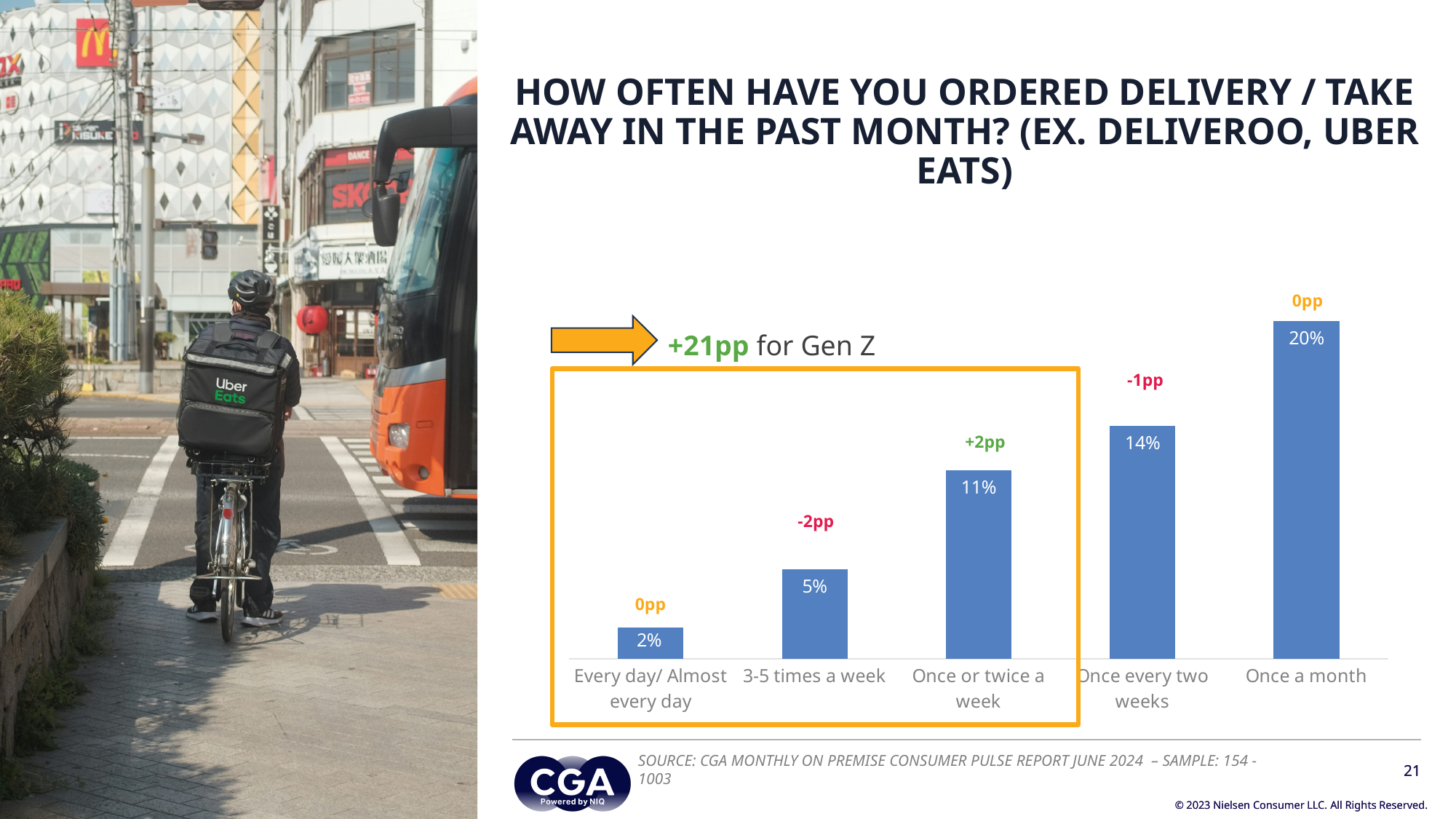
Do the values rise or fall moving from left to right along the x axis? Rise How many categories are shown on the x axis? 5 What change for Gen Z is highlighted next to the orange arrow? +21pp What percentage of respondents ordered delivery / take away every day / almost every day? 2% What is the difference between the values for 'Once a month' and 'Once every two weeks'? 6 percentage points Which category has the highest value? Once a month What percentage of respondents ordered delivery / take away 3-5 times a week? 5% What kind of chart is shown on the slide? Bar chart Which is larger: the value for 'Once or twice a week' or the value for '3-5 times a week'? Once or twice a week What is the change in percentage points shown above the '3-5 times a week' bar? -2pp Which category has the lowest value? Every day/ Almost every day What percentage of respondents ordered delivery / take away once a month? 20%